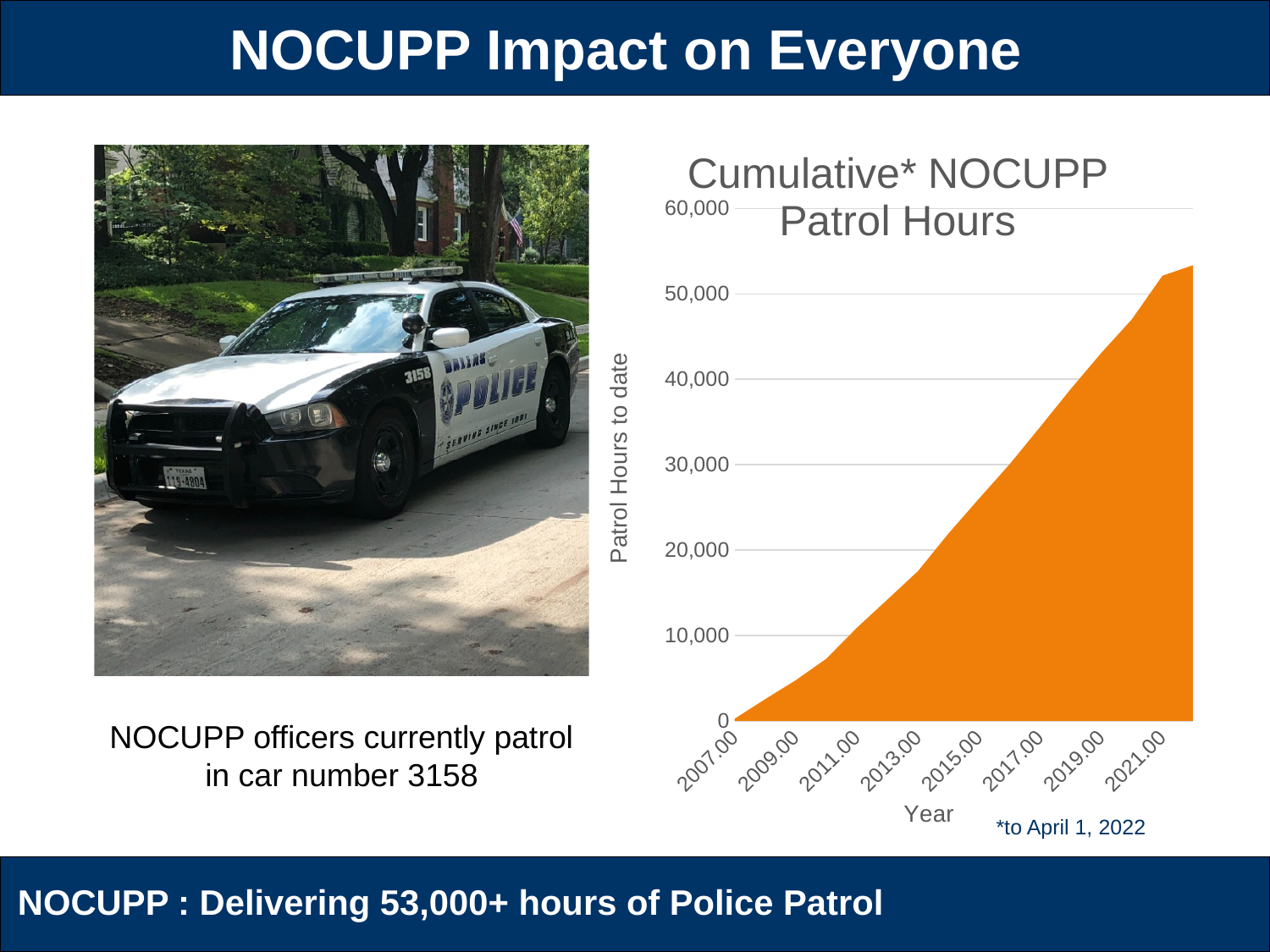
Do the cumulative patrol hours rise or fall as the years increase along the x axis? rise Which year shown on the x axis has the lowest cumulative patrol hours? 2007.00 Is the value for 2015.00 greater or less than 30,000? less Which year shown on the x axis has the highest cumulative patrol hours? 2021.00 Is the value for 2009.00 greater or less than 10,000? less Is the highest value reached by the area greater or less than 50,000? greater What is the label of the y axis? Patrol Hours to date What kind of chart is shown on the slide? area chart What is the title of the chart? Cumulative* NOCUPP Patrol Hours